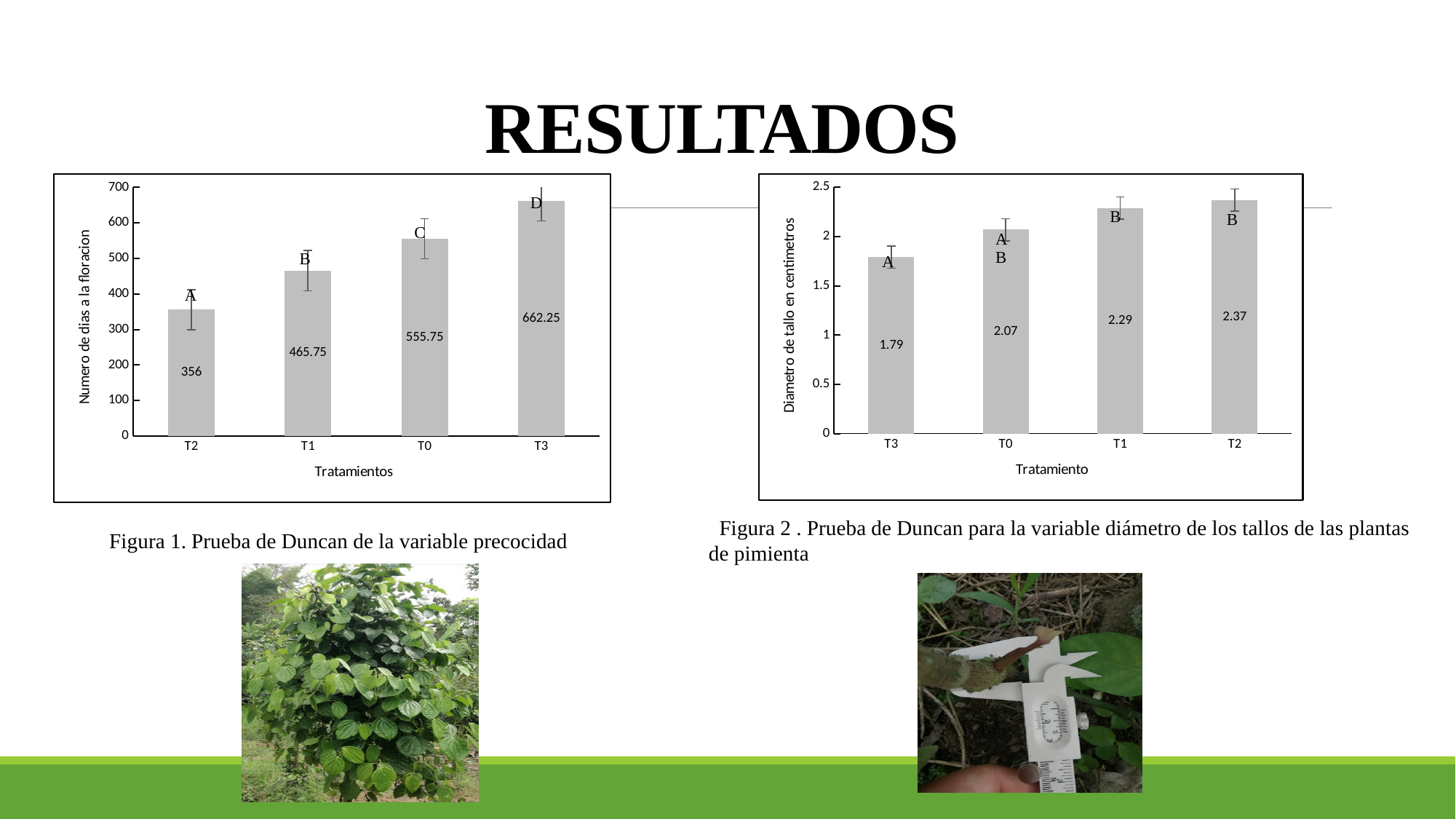
What kind of chart is the right chart (Figura 2)? bar chart In the right chart (Figura 2), do the values rise or fall from left to right along the x axis? rise In the left chart (Figura 1), what is the difference between the values for T3 and T2? 306.25 In the left chart (Figura 1), which treatment has the highest number of days to flowering? T3 In the right chart (Figura 2), which treatment has the largest stem diameter? T2 In the left chart (Figura 1), how many treatments are plotted? 4 In the right chart (Figura 2, Diametro de tallo en centimetros), what is the value for T0? 2.07 In the right chart (Figura 2), which treatment has the smallest stem diameter? T3 In the left chart (Figura 1, Numero de dias a la floracion), what is the value for T1? 465.75 In the left chart (Figura 1), is the value for T0 greater or less than 500? greater In the left chart (Figura 1), which treatment has the lowest number of days to flowering? T2 In the right chart (Figura 2), what is the difference between the values for T2 and T3? 0.58